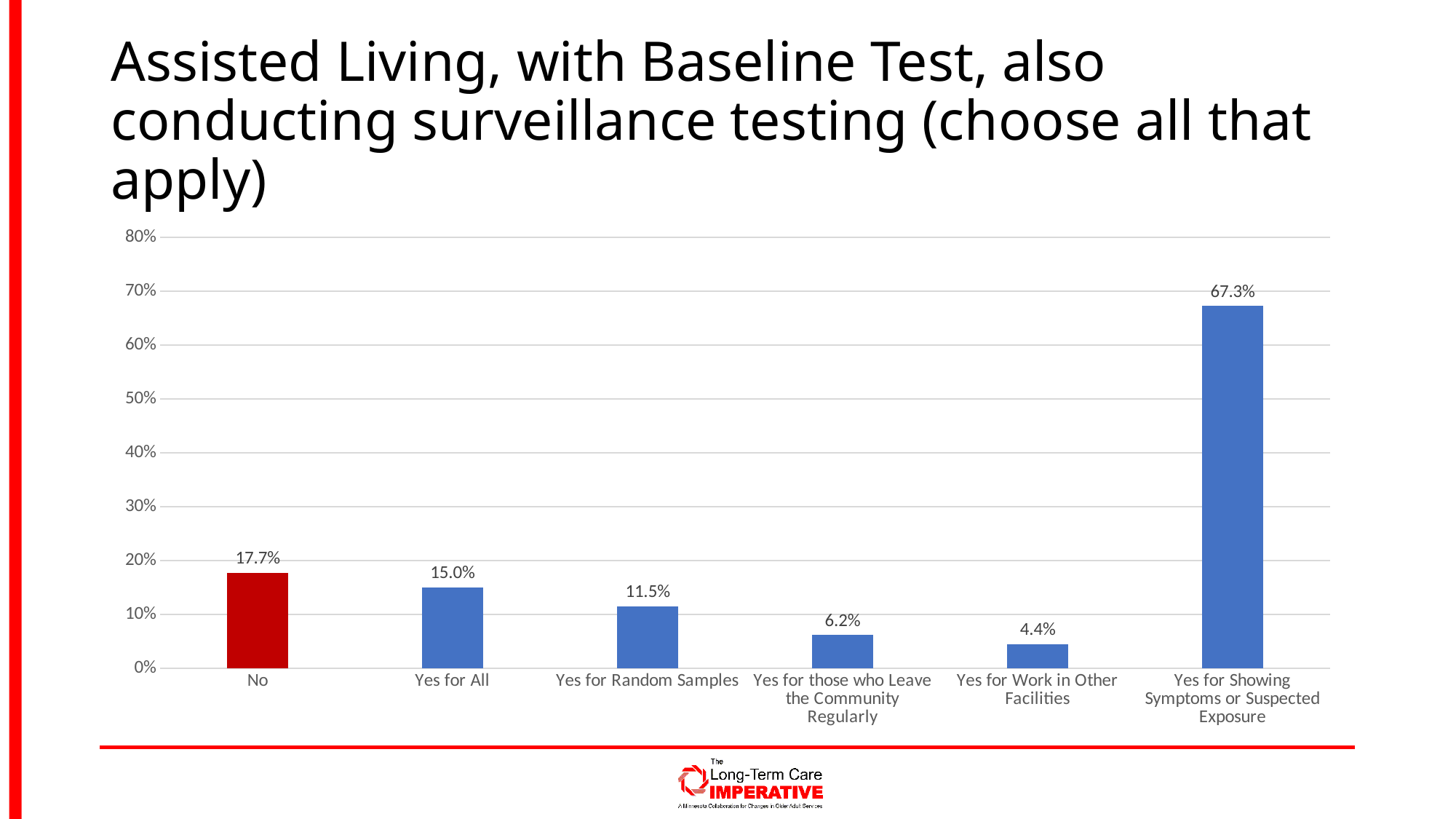
Which is larger, the value for "Yes for Random Samples" or the value for "Yes for those who Leave the Community Regularly"? Yes for Random Samples What is the value for "Yes for Work in Other Facilities"? 4.4% What is the value for "No"? 17.7% What is the value for "Yes for Random Samples"? 11.5% What is the value for "Yes for Showing Symptoms or Suspected Exposure"? 67.3% What kind of chart is shown on the slide? Bar chart What is the difference between the values for "Yes for Showing Symptoms or Suspected Exposure" and "Yes for All"? 52.3% Which category has the highest value? Yes for Showing Symptoms or Suspected Exposure What is the difference between the values for "No" and "Yes for All"? 2.7% Which bar is coloured red rather than blue? No How many categories are shown on the chart? 6 Which category has the lowest value? Yes for Work in Other Facilities